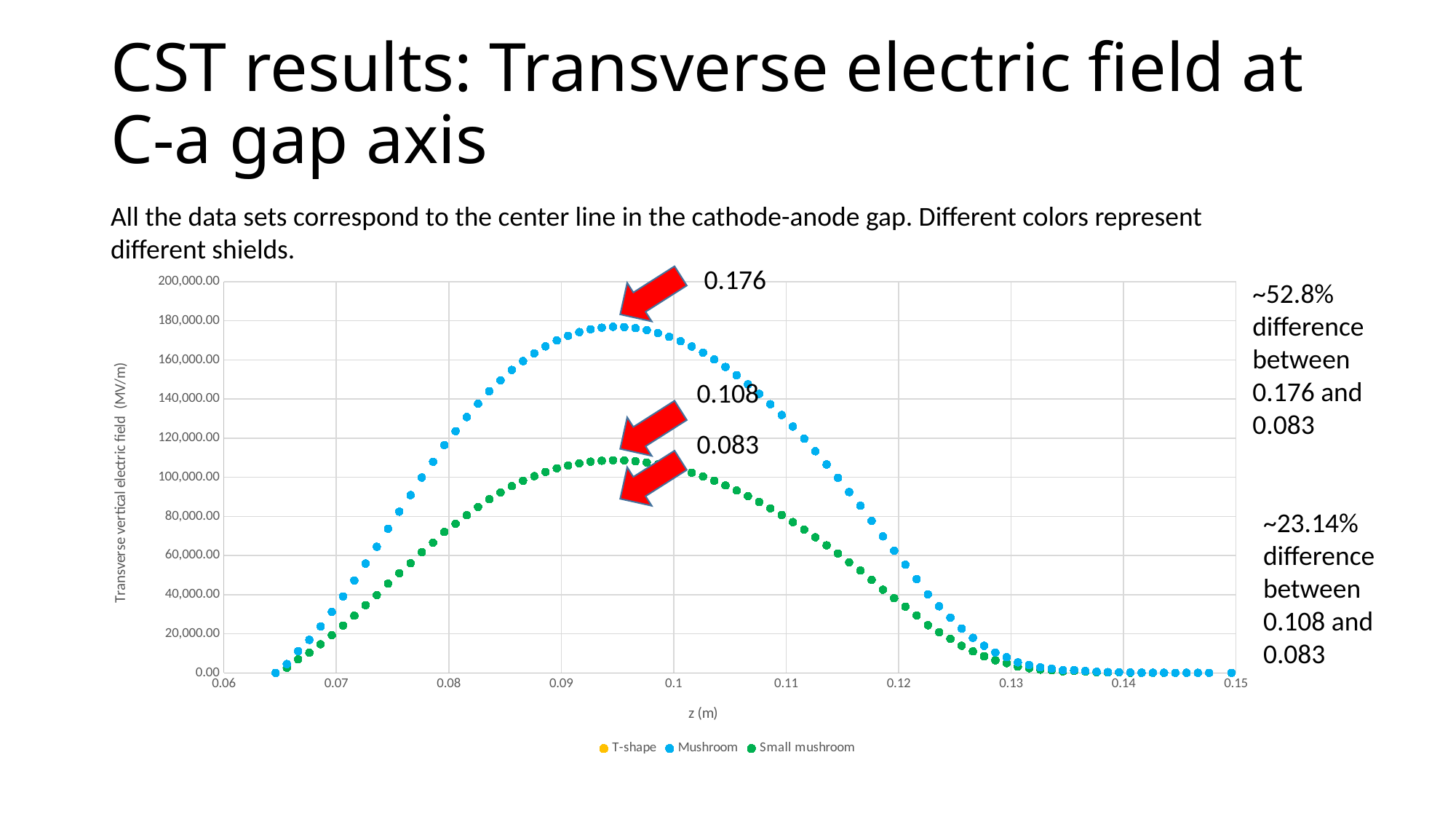
Which series reaches the higher peak value, Mushroom or Small mushroom? Mushroom Is the value of the Small mushroom series at z = 0.13 greater or less than 20,000.00? less How do the values of the Mushroom series change as z increases from 0.06 to 0.15? rise to a peak near z = 0.095, then fall What are the three series named in the chart legend? T-shape, Mushroom, Small mushroom Is the peak value of the Mushroom series greater or less than 160,000.00? greater What is the maximum value shown on the y axis of the chart? 200,000.00 Is the value of the Mushroom series at z = 0.09 greater or less than 160,000.00? greater How many series does the chart legend list? 3 According to the annotation on the slide, what is the percentage difference between 0.176 and 0.083? ~52.8% What kind of chart is shown on the slide? scatter chart What is the label of the x axis of the chart? z (m)